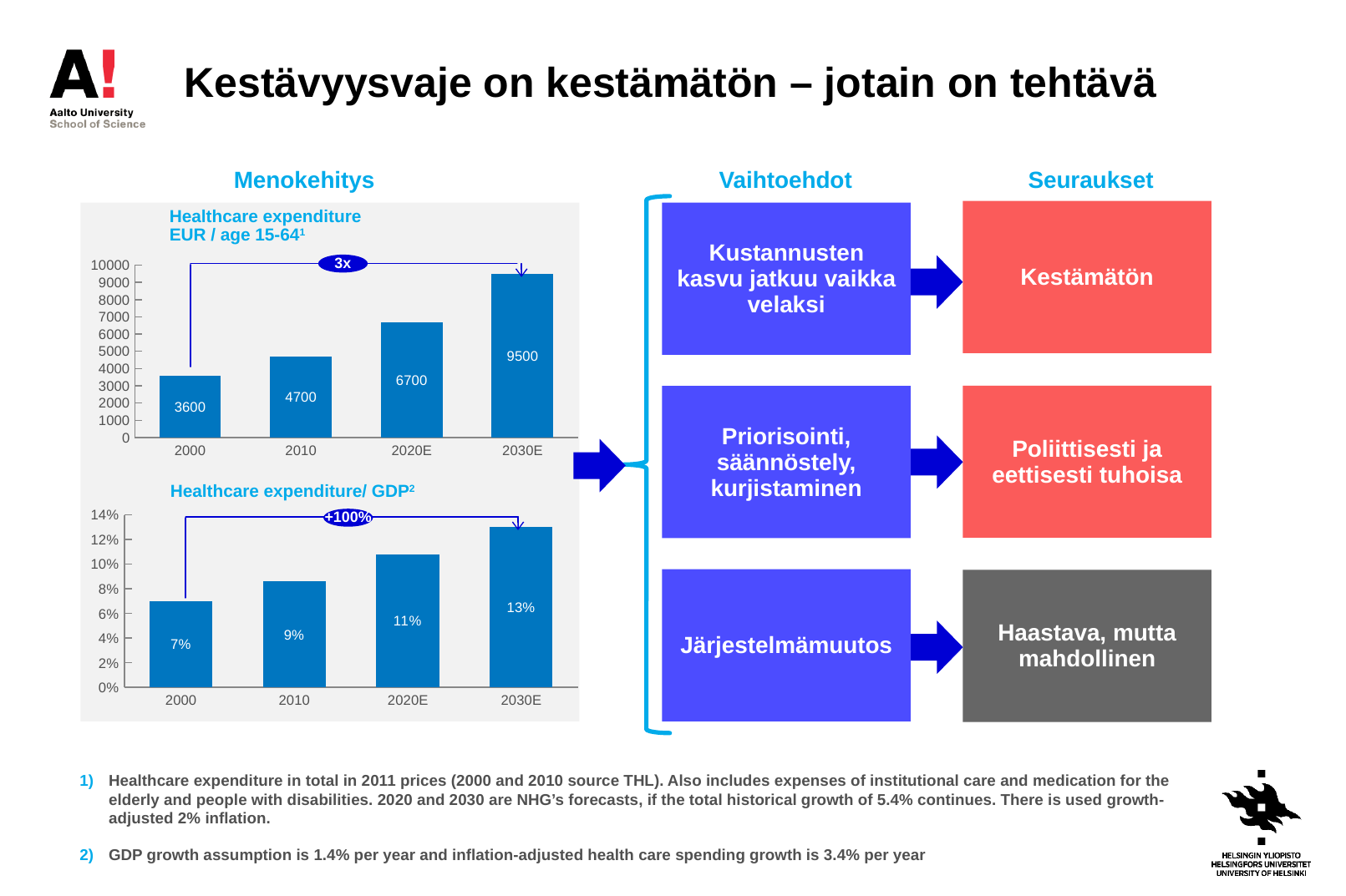
In the 'Healthcare expenditure/ GDP' chart, what is the difference between the 2020E and 2000 values? 4% In the 'Healthcare expenditure/ GDP' chart, what is the value for 2030E? 13% In the 'Healthcare expenditure EUR / age 15-64' chart, what is the value for 2000? 3600 In the 'Healthcare expenditure/ GDP' chart, do the values rise or fall from 2000 to 2030E? rise In the 'Healthcare expenditure/ GDP' chart, which year has the lowest value? 2000 In the 'Healthcare expenditure EUR / age 15-64' chart, what is the difference between the 2030E and 2000 values? 5900 In the 'Healthcare expenditure EUR / age 15-64' chart, which year has the highest value? 2030E In the 'Healthcare expenditure EUR / age 15-64' chart, how many bars are plotted? 4 What type of chart is the 'Healthcare expenditure/ GDP' chart? bar chart In the 'Healthcare expenditure EUR / age 15-64' chart, what is the value for 2020E? 6700 In the 'Healthcare expenditure EUR / age 15-64' chart, is the value for 2010 greater or less than 5000? less In the 'Healthcare expenditure/ GDP' chart, what is the value for 2010? 9%